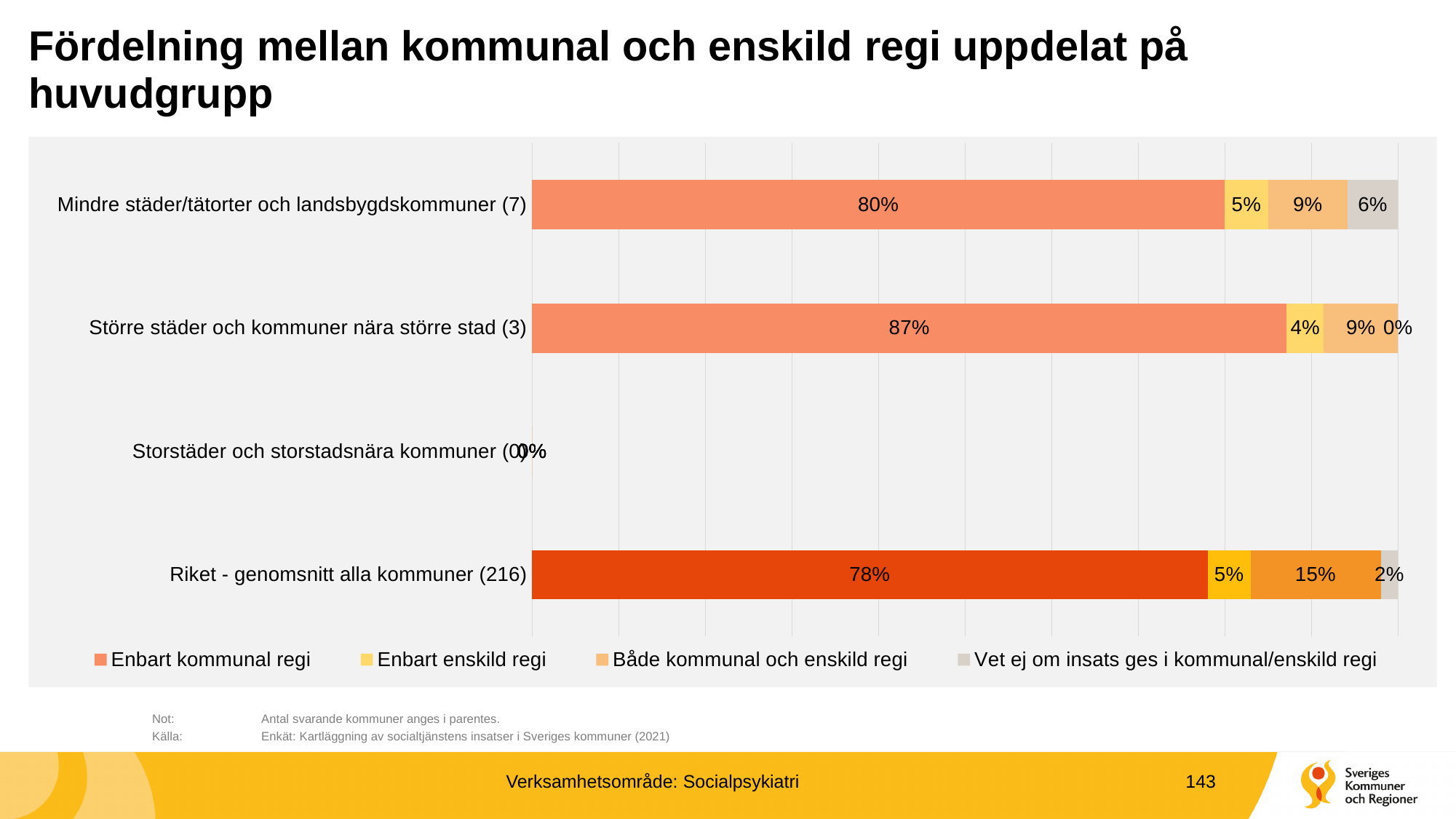
What kind of chart is shown on the slide? Stacked bar chart What is the value of 'Enbart enskild regi' for 'Större städer och kommuner nära större stad (3)'? 4% How many responding municipalities are indicated in parentheses for 'Riket - genomsnitt alla kommuner'? 216 What is the value of 'Enbart kommunal regi' for 'Mindre städer/tätorter och landsbygdskommuner (7)'? 80% What is the difference in 'Enbart kommunal regi' between 'Större städer och kommuner nära större stad (3)' and 'Riket - genomsnitt alla kommuner (216)'? 9 percentage points Which category has the highest value for 'Enbart kommunal regi'? Större städer och kommuner nära större stad (3) What is the value of 'Både kommunal och enskild regi' for 'Riket - genomsnitt alla kommuner (216)'? 15% What is the value of 'Vet ej om insats ges i kommunal/enskild regi' for 'Mindre städer/tätorter och landsbygdskommuner (7)'? 6% What is the value of 'Enbart kommunal regi' for 'Större städer och kommuner nära större stad (3)'? 87% How many series does the legend list? 4 How many categories are shown on the y axis of the chart? 4 Which is larger: 'Både kommunal och enskild regi' for 'Riket - genomsnitt alla kommuner (216)' or for 'Mindre städer/tätorter och landsbygdskommuner (7)'? Riket - genomsnitt alla kommuner (216)